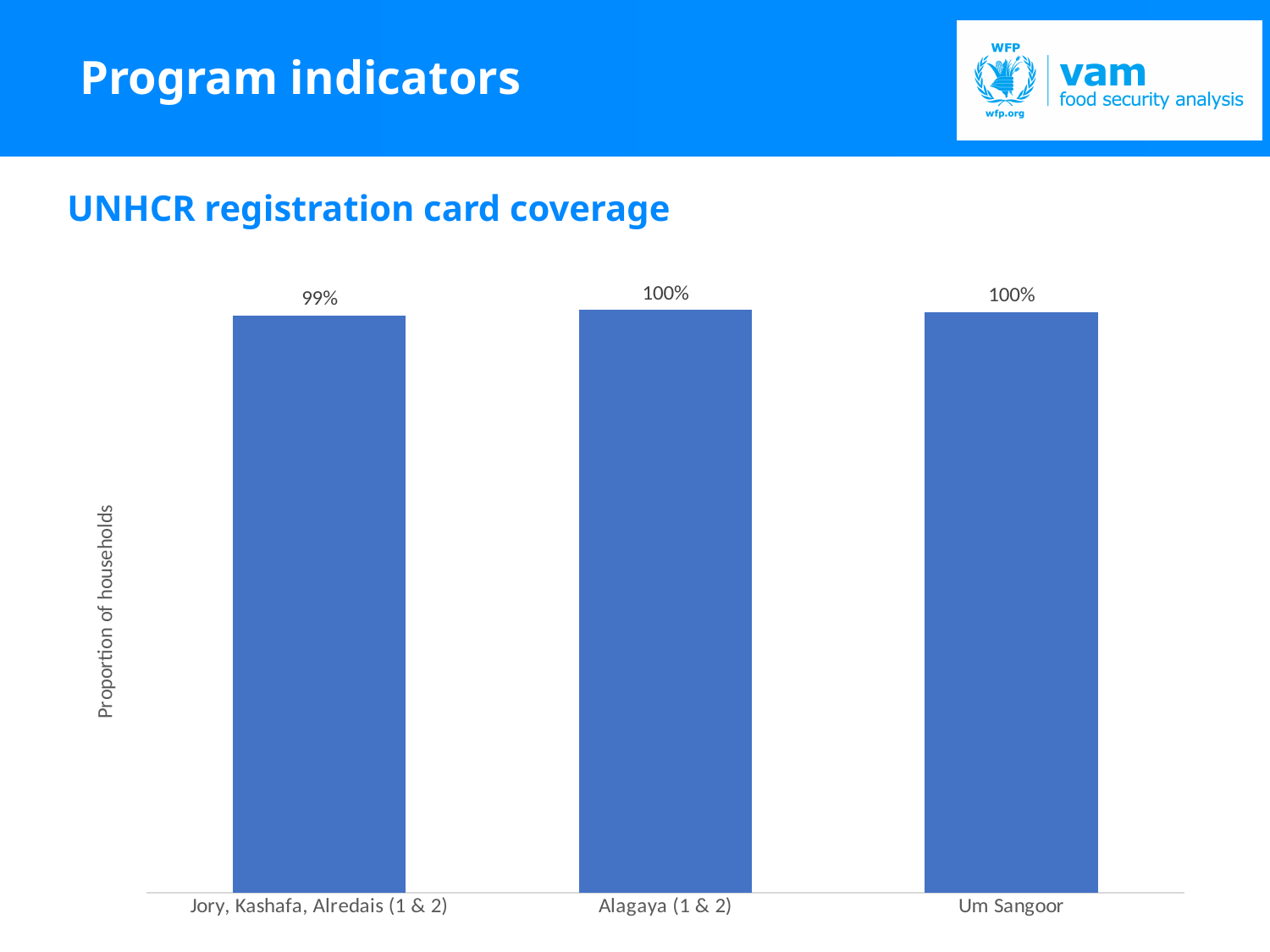
What is the UNHCR registration card coverage for Alagaya (1 & 2)? 100% Which location has the lowest UNHCR registration card coverage? Jory, Kashafa, Alredais (1 & 2) Do the two locations Alagaya (1 & 2) and Um Sangoor have the same coverage value? Yes How many locations are shown in the chart? 3 What is the label on the vertical axis of the chart? Proportion of households What is the difference in coverage between Um Sangoor and Jory, Kashafa, Alredais (1 & 2)? 1% What is the UNHCR registration card coverage for Jory, Kashafa, Alredais (1 & 2)? 99% What kind of chart is shown on the slide? Bar chart What is the UNHCR registration card coverage for Um Sangoor? 100% Which has higher coverage, Alagaya (1 & 2) or Jory, Kashafa, Alredais (1 & 2)? Alagaya (1 & 2) What is the title of the chart? UNHCR registration card coverage